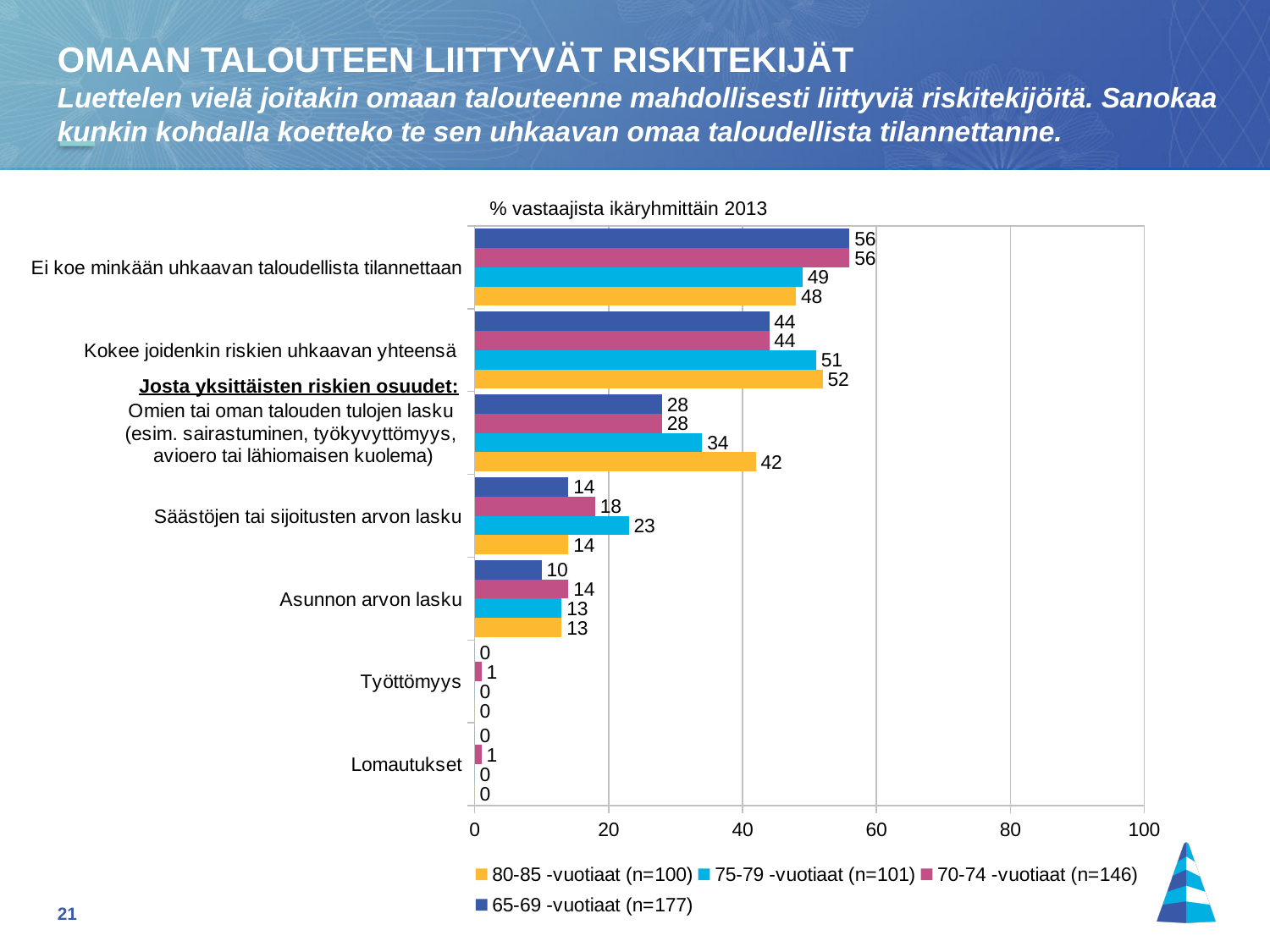
For "Säästöjen tai sijoitusten arvon lasku", which is larger: the value for 70-74 -vuotiaat or for 80-85 -vuotiaat? 70-74 -vuotiaat What is the value for 70-74 -vuotiaat (n=146) for "Ei koe minkään uhkaavan taloudellista tilannettaan"? 56 What is the value for 65-69 -vuotiaat (n=177) for "Asunnon arvon lasku"? 10 What is the value for 80-85 -vuotiaat (n=100) for "Omien tai oman talouden tulojen lasku"? 42 Which age group has the lowest value for "Asunnon arvon lasku"? 65-69 -vuotiaat (n=177) What is the value for 75-79 -vuotiaat (n=101) for "Säästöjen tai sijoitusten arvon lasku"? 23 What kind of chart is shown on the slide? Bar chart What is the difference between the 80-85 -vuotiaat and 65-69 -vuotiaat values for "Omien tai oman talouden tulojen lasku"? 14 Which age group has the highest value for "Kokee joidenkin riskien uhkaavan yhteensä"? 80-85 -vuotiaat (n=100) How many categories are shown on the y axis of the chart? 7 How many series does the legend list? 4 What is the title shown above the chart? % vastaajista ikäryhmittäin 2013